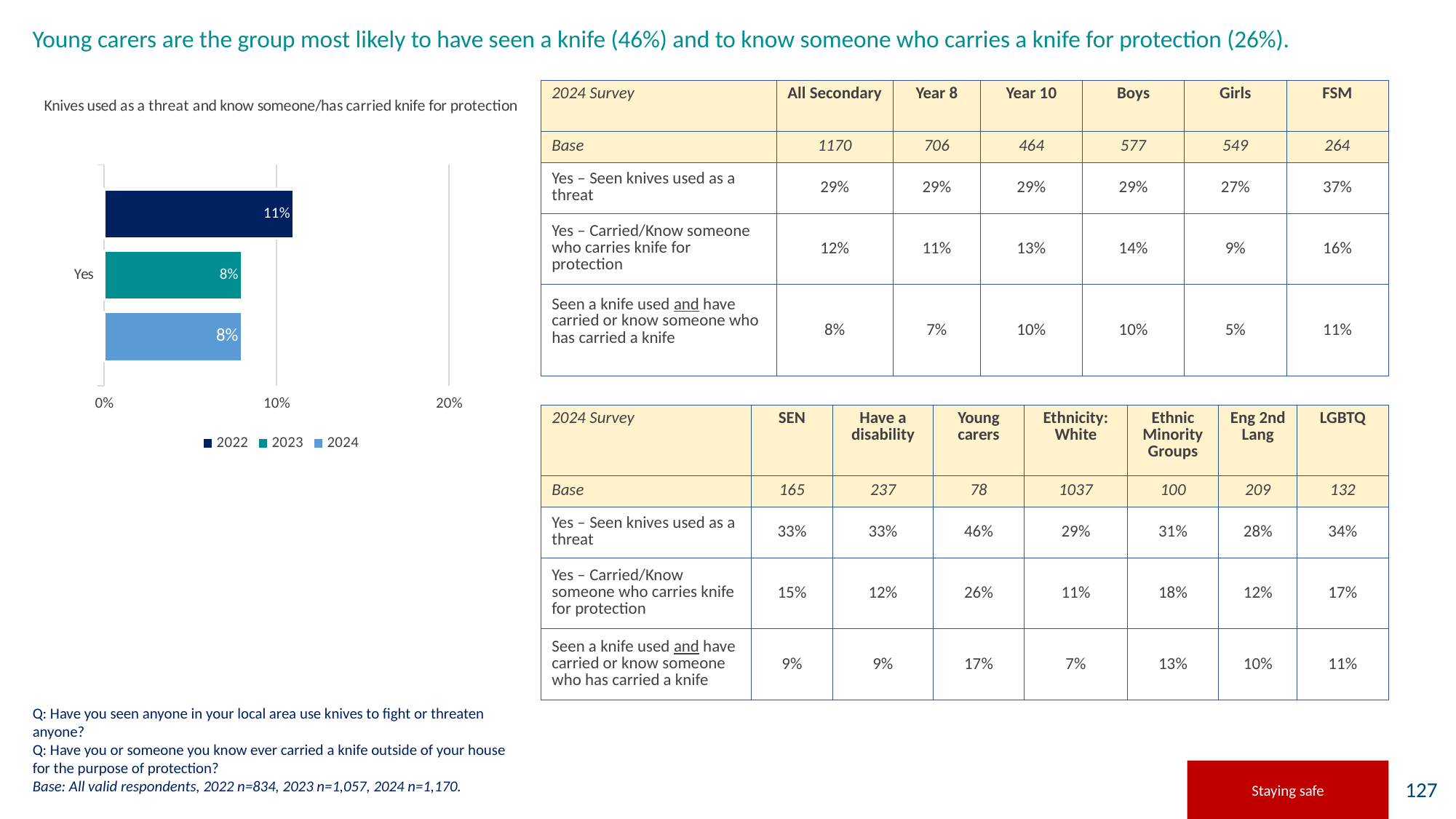
What is the value for 2024 in the chart? 8% Is the value for 2024 in the chart greater or less than 10%? less Is the value for 2022 in the chart greater or less than 10%? greater How many series does the chart legend list? 3 What is the difference between the 2022 and 2024 values in the chart? 3% What is the value for 2022 in the chart? 11% Which year has the highest value in the chart? 2022 What is the title of the chart? Knives used as a threat and know someone/has carried knife for protection What is the category label on the chart's vertical axis? Yes What is the value for 2023 in the chart? 8% What kind of chart is shown on the slide? bar chart Which is larger in the chart, the value for 2022 or the value for 2023? 2022